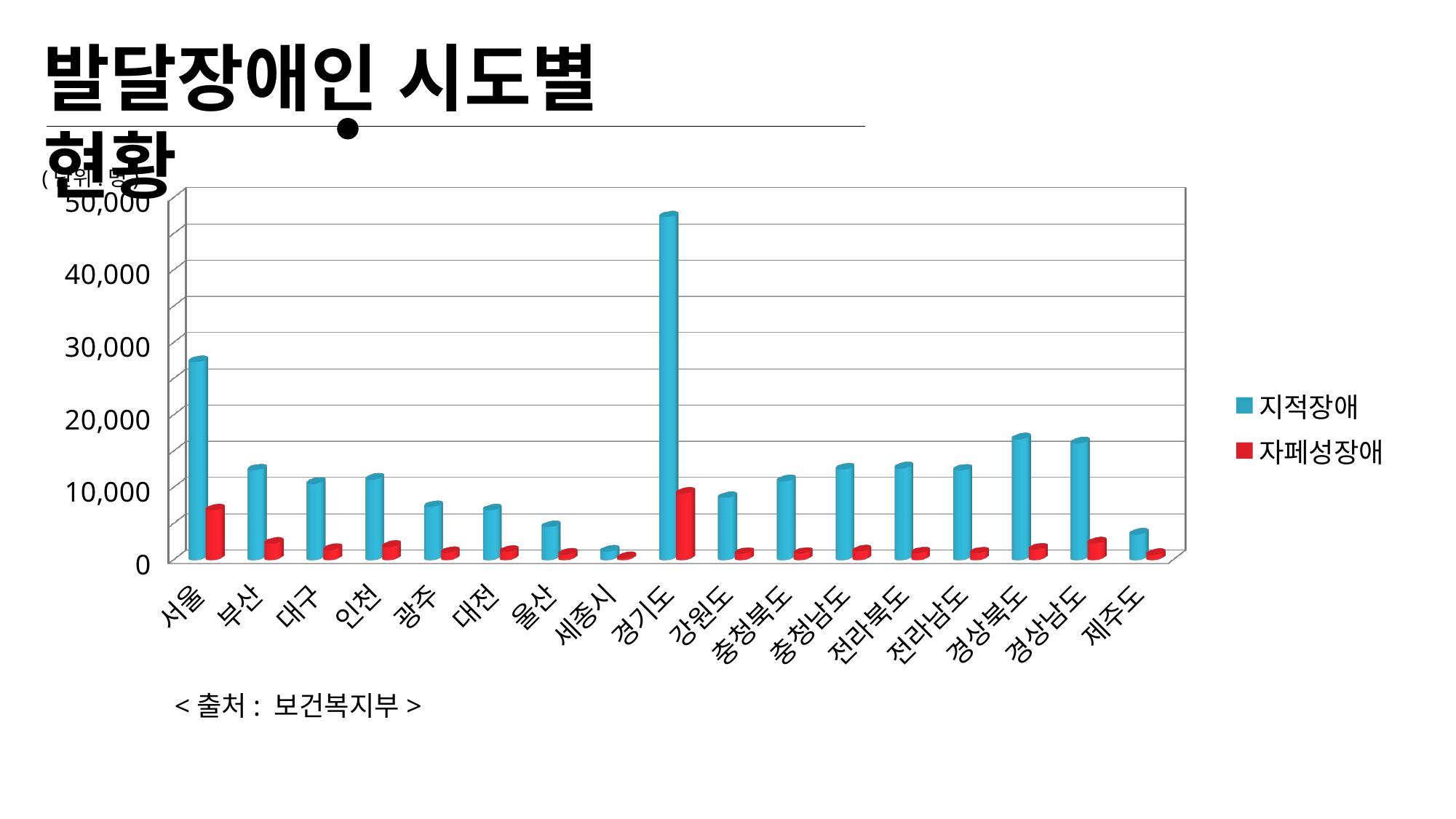
Which is larger, the 지적장애 value for 서울 or for 부산? 서울 Which region has the highest value for 자폐성장애? 경기도 Is the 지적장애 value for 경기도 greater or less than 40,000? greater Is the 지적장애 value for 세종시 greater or less than 10,000? less Is the 지적장애 value for 서울 greater or less than 20,000? greater Which is larger, the 자폐성장애 value for 경기도 or for 강원도? 경기도 Which region has the lowest value for 지적장애? 세종시 Which region has the highest value for 지적장애? 경기도 What kind of chart is shown on the slide? bar chart What are the two series names listed in the legend? 지적장애, 자페성장애 How many regions (categories) are shown on the x axis? 17 How many series does the legend list? 2